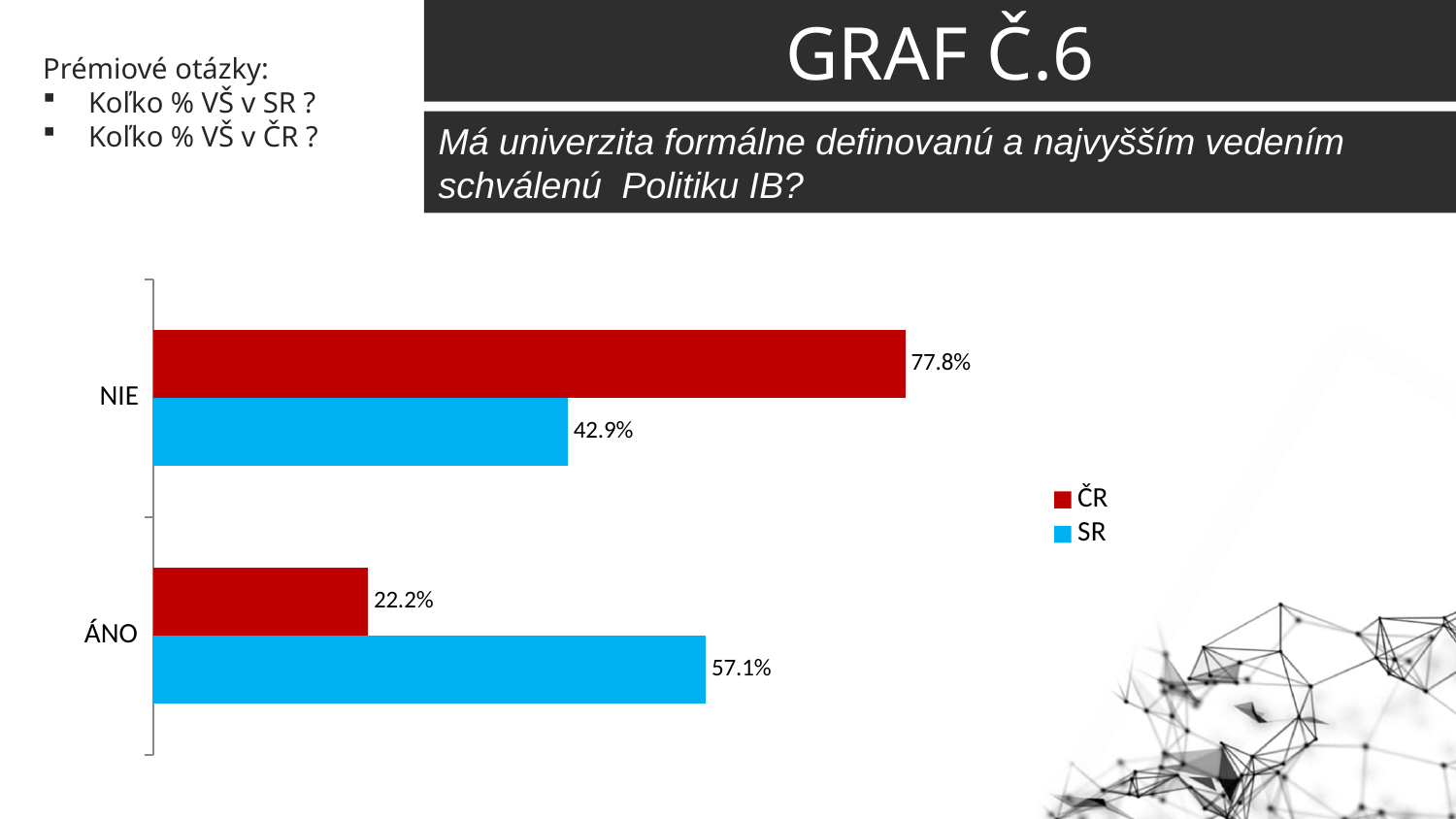
Which is larger in the ÁNO category, ČR or SR? SR How many series does the legend list? 2 Which category has the highest value for the ČR series? NIE What kind of chart is shown on the slide? Bar chart Which colour represents the SR series in the legend? Blue How many categories are shown on the chart? 2 Which category has the lowest value for the SR series? NIE What is the value for SR in the NIE category? 42.9% What is the value for SR in the ÁNO category? 57.1% What is the difference between the ČR and SR values in the NIE category? 34.9% What is the value for ČR in the NIE category? 77.8% What is the value for ČR in the ÁNO category? 22.2%